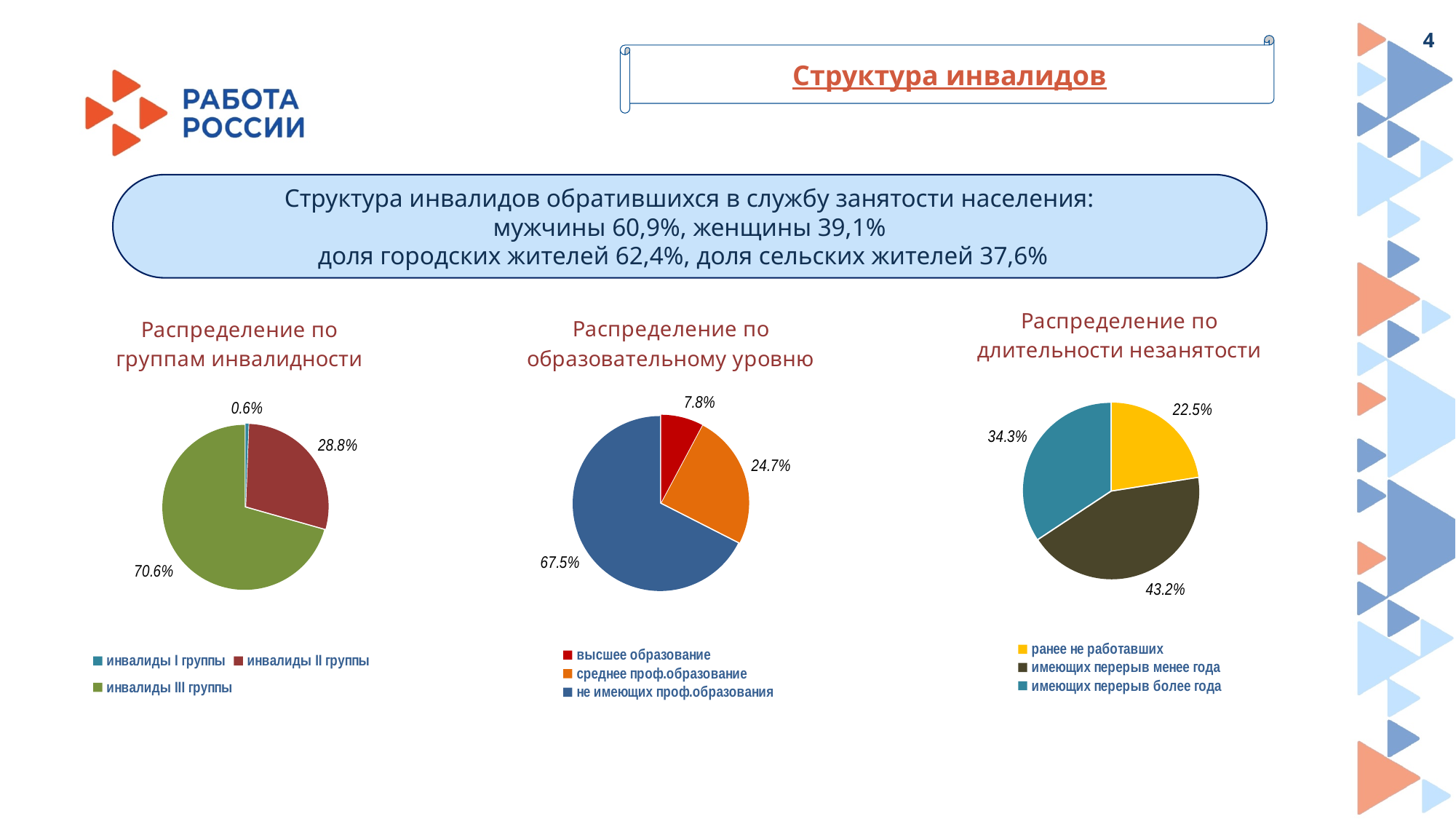
What kind of chart is 'Распределение по образовательному уровню'? pie chart In the chart 'Распределение по длительности незанятости', what share is shown for имеющих перерыв более года? 34.3% In the chart 'Распределение по группам инвалидности', what is the difference between the shares of инвалиды III группы and инвалиды II группы? 41.8% In the chart 'Распределение по образовательному уровню', what share is shown for среднее проф.образование? 24.7% In the chart 'Распределение по группам инвалидности', what share is shown for инвалиды III группы? 70.6% How many pie charts are shown on the slide? 3 In the chart 'Распределение по образовательному уровню', which is larger: высшее образование or среднее проф.образование? среднее проф.образование How many categories does the legend of the chart 'Распределение по длительности незанятости' list? 3 In the chart 'Распределение по длительности незанятости', which category has the largest share? имеющих перерыв менее года In the chart 'Распределение по образовательному уровню', which category has the largest share? не имеющих проф.образования In the chart 'Распределение по группам инвалидности', which group has the smallest share? инвалиды I группы In the chart 'Распределение по длительности незанятости', what is the difference between the shares of имеющих перерыв менее года and ранее не работавших? 20.7%